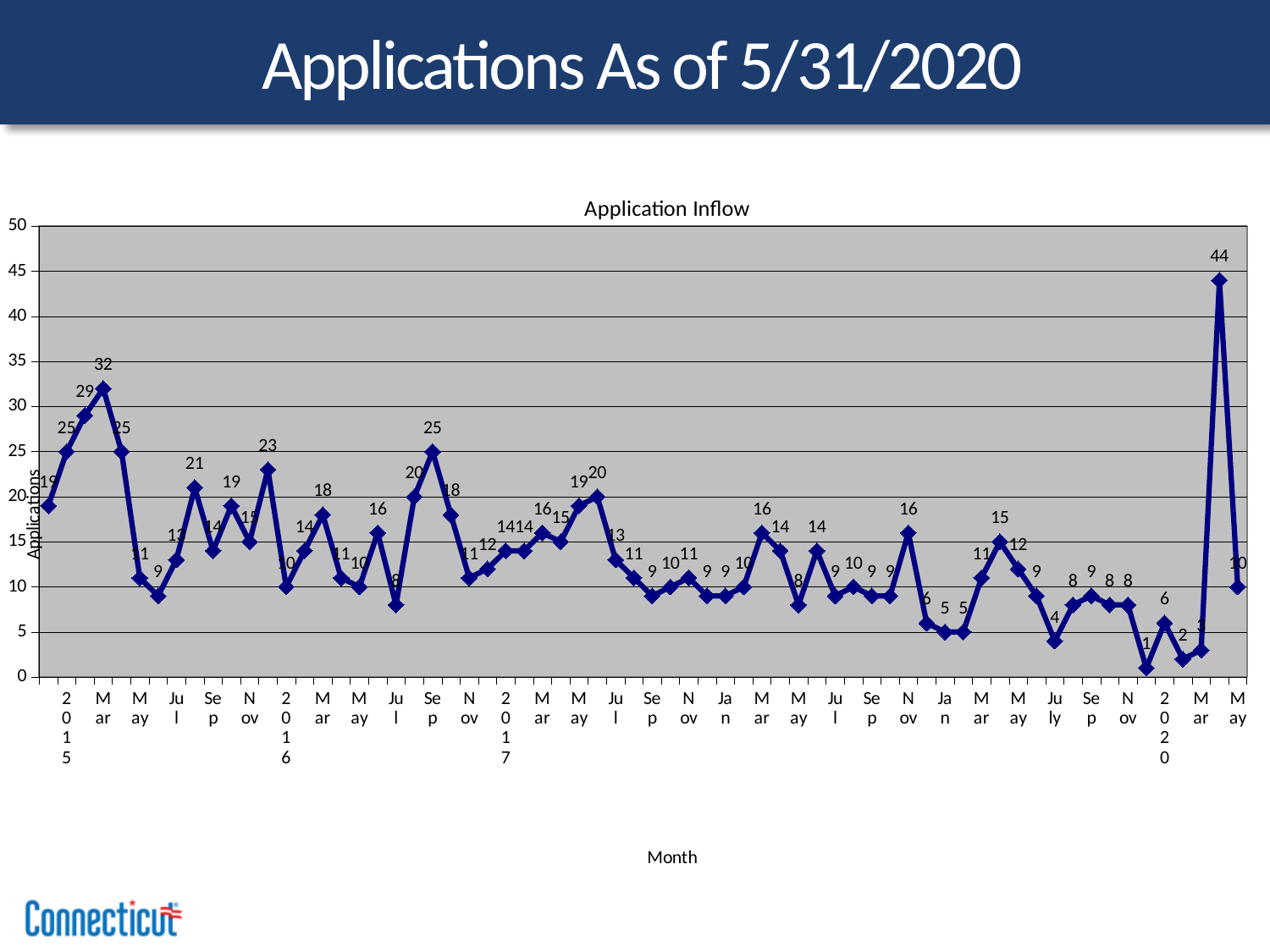
What is the lowest value plotted on the chart? 1 What is the value for Sep 2016? 25 What is the label on the x axis of the chart? Month Is the peak value on the chart greater or less than 40? greater What is the title of the chart? Application Inflow Which is larger, the value for Mar 2015 or the value for Sep 2016? Mar 2015 What is the highest value plotted on the chart? 44 What is the value for Nov 2018? 16 What is the value for the last point, May 2020? 10 What is the difference between the peak value of 44 and the final value of 10? 34 What is the value for Mar 2015? 32 What type of chart is shown on the slide? line chart